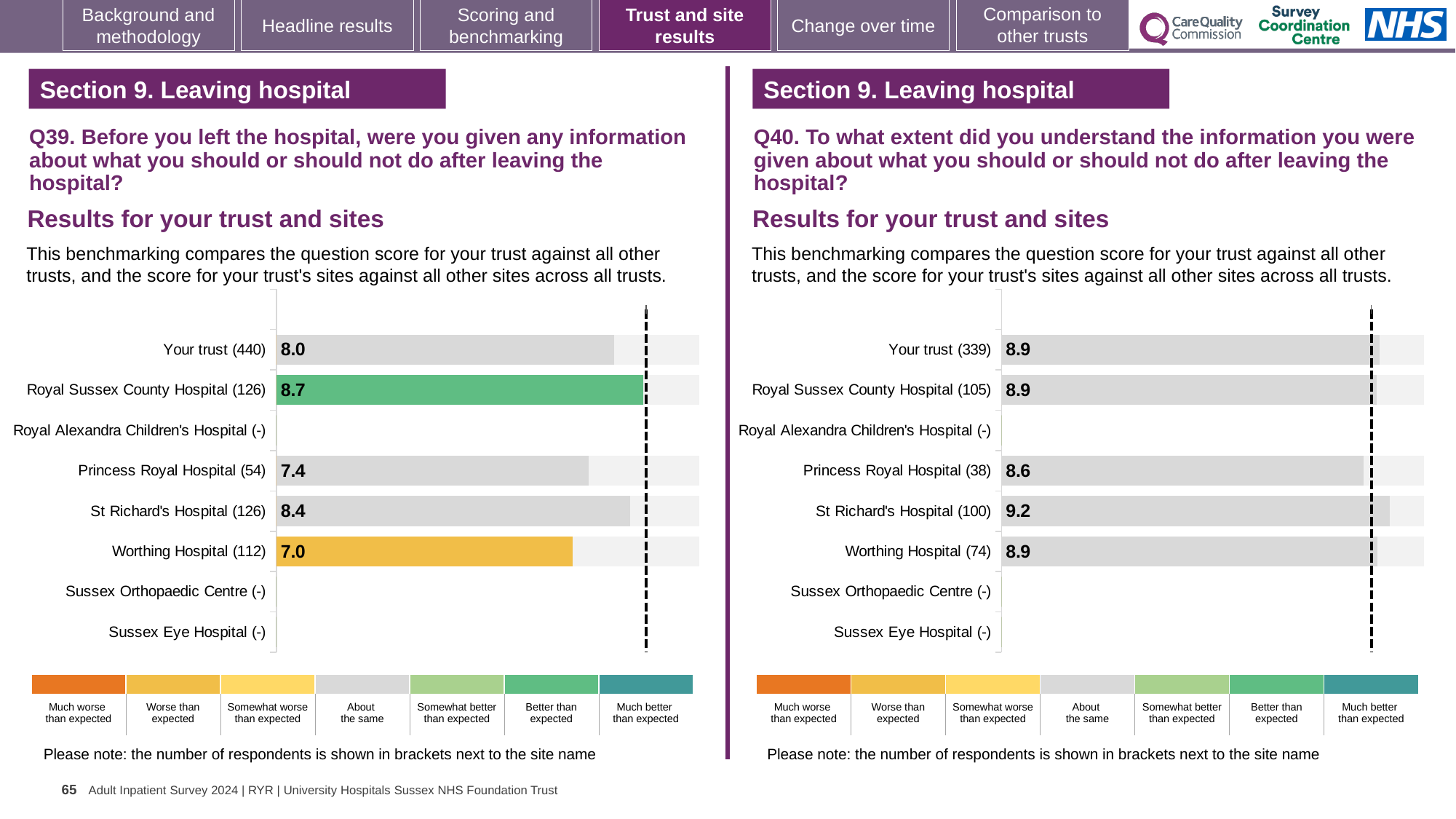
In the Q39 chart on the left, which has the higher score: St Richard's Hospital or Princess Royal Hospital? St Richard's Hospital In the Q39 chart on the left, which site has the lowest score? Worthing Hospital In the Q39 chart on the left, what is the difference between the scores for Royal Sussex County Hospital and Worthing Hospital? 1.7 In the Q40 chart on the right, what is the difference between the scores for St Richard's Hospital and Princess Royal Hospital? 0.6 In the Q40 chart on the right, what is the score for St Richard's Hospital? 9.2 In the Q40 chart on the right, how many rows have a score shown? 5 In the Q39 chart on the left, what is the score for Worthing Hospital? 7.0 In the Q39 chart on the left, what is the score for Royal Sussex County Hospital? 8.7 In the Q39 chart on the left, which site has the highest score? Royal Sussex County Hospital In the Q40 chart on the right, which site has the highest score? St Richard's Hospital What type of chart is used for the Q39 results on the left? Bar chart In the Q40 chart on the right, what is the score for Princess Royal Hospital? 8.6